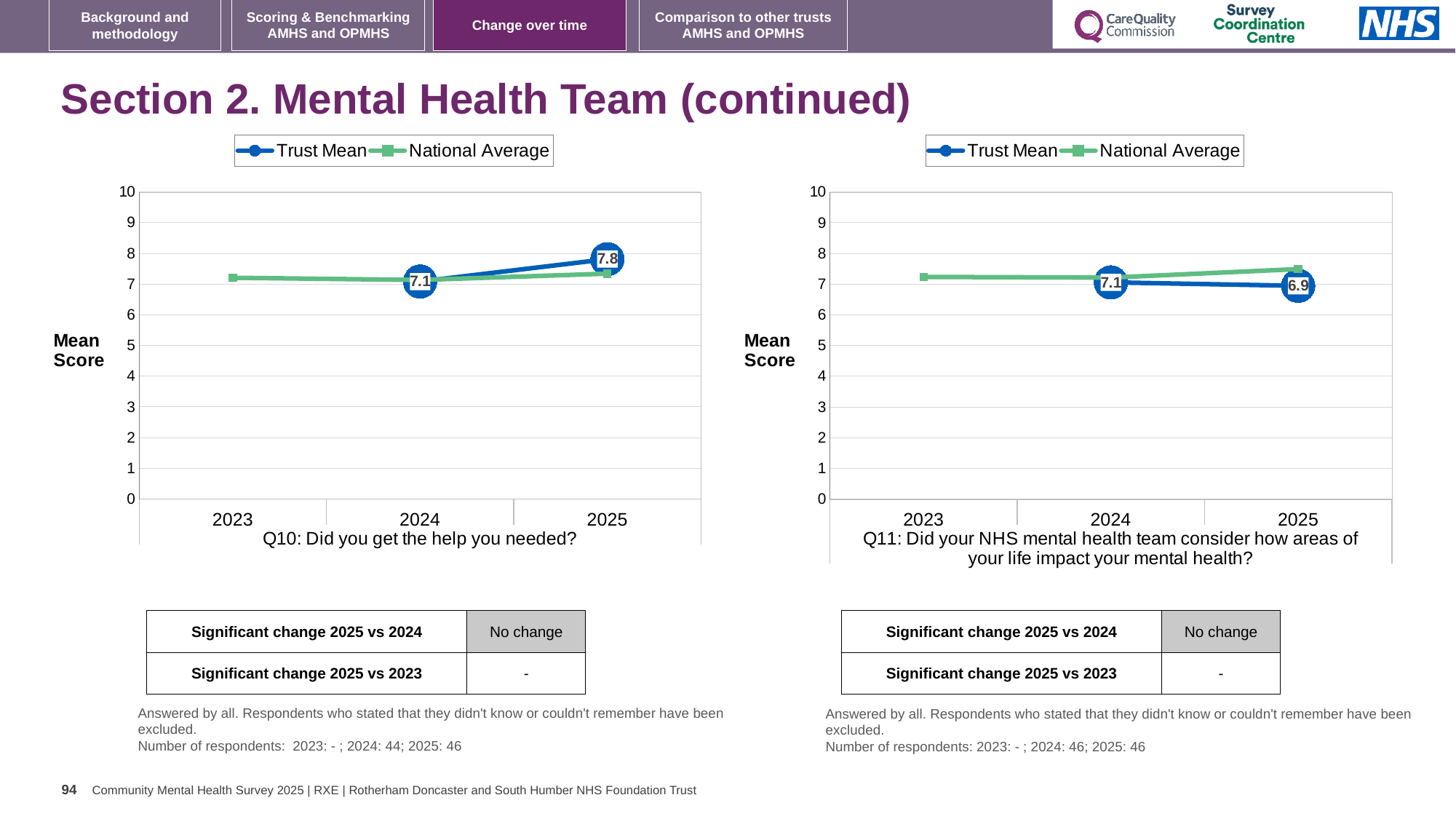
What type of chart is used for Q10 on the left? line chart In the Q10 chart (left), what is the Trust Mean score for 2025? 7.8 In the Q11 chart (right), is the National Average value for 2023 greater or less than 5? greater In the Q10 chart (left), what is the Trust Mean score for 2024? 7.1 In the Q11 chart (right), does the Trust Mean rise or fall from 2024 to 2025? fall How many years are shown on the x axis of the Q10 chart (left)? 3 In the Q11 chart (right), what is the Trust Mean score for 2024? 7.1 How many series does the legend of the Q11 chart (right) list? 2 In the Q11 chart (right), what is the difference between the Trust Mean in 2024 and in 2025? 0.2 In the Q10 chart (left), does the Trust Mean rise or fall from 2024 to 2025? rise In the Q10 chart (left), by how much did the Trust Mean change from 2024 to 2025? 0.7 In the Q11 chart (right), what is the Trust Mean score for 2025? 6.9